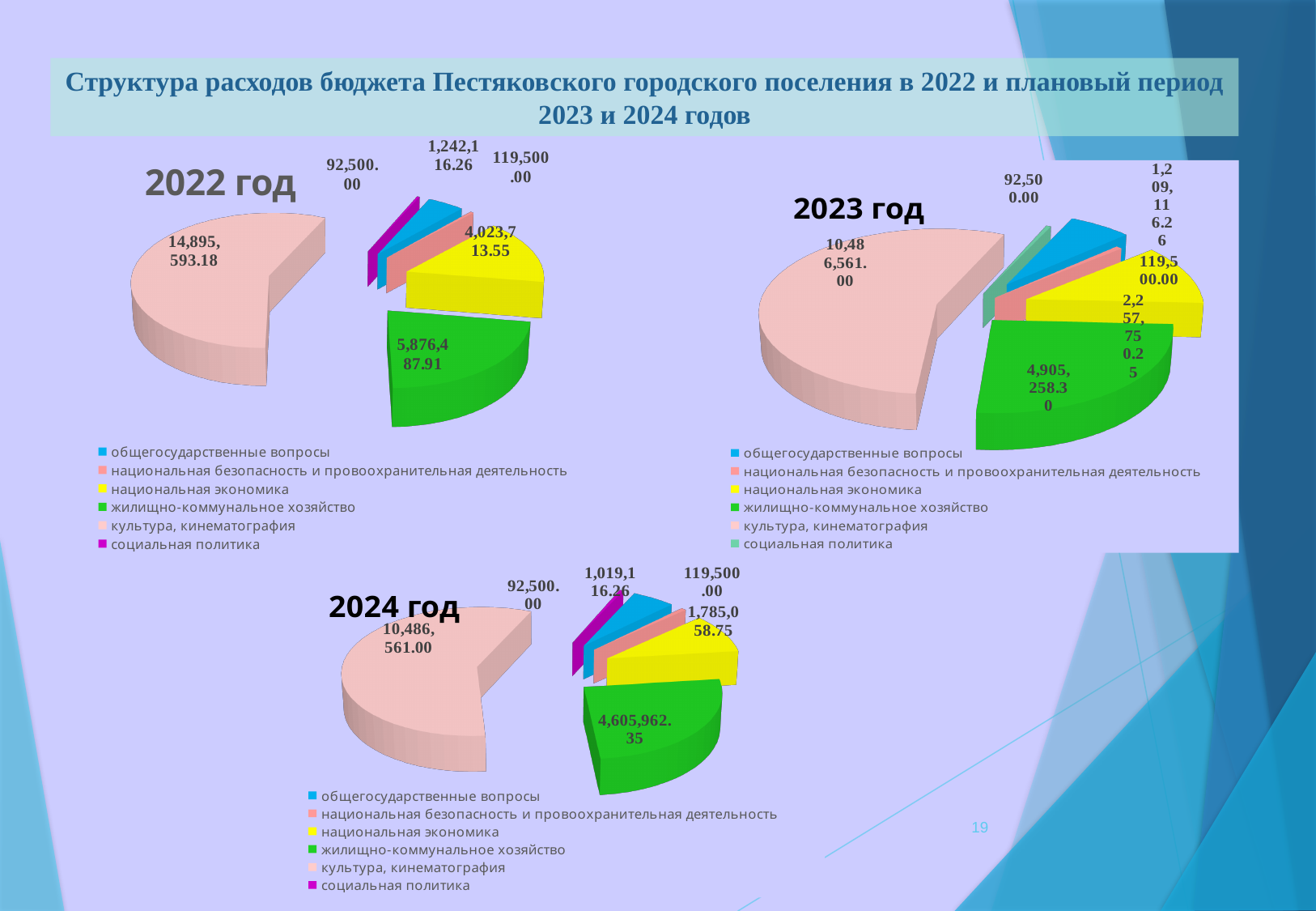
In the "2022 год" pie chart, which category has the smallest slice? социальная политика In the "2023 год" pie chart, what is the value for жилищно-коммунальное хозяйство? 4,905,258.30 In the "2022 год" pie chart, what is the value for жилищно-коммунальное хозяйство? 5,876,487.91 In the "2022 год" pie chart, which category has the largest slice? культура, кинематография In the "2023 год" pie chart, what is the value for национальная экономика? 2,257,750.25 In the "2024 год" pie chart, what is the difference between культура, кинематография and жилищно-коммунальное хозяйство? 5,880,598.65 In the "2024 год" pie chart, which is larger: национальная экономика or жилищно-коммунальное хозяйство? жилищно-коммунальное хозяйство How many categories does the legend of the "2023 год" pie chart list? 6 In the "2024 год" pie chart, what is the value for общегосударственные вопросы? 1,019,116.26 In the "2022 год" pie chart, what is the value for культура, кинематография? 14,895,593.18 In the "2022 год" pie chart, which colour represents национальная экономика? Yellow What type of chart is used for "2022 год"? Pie chart